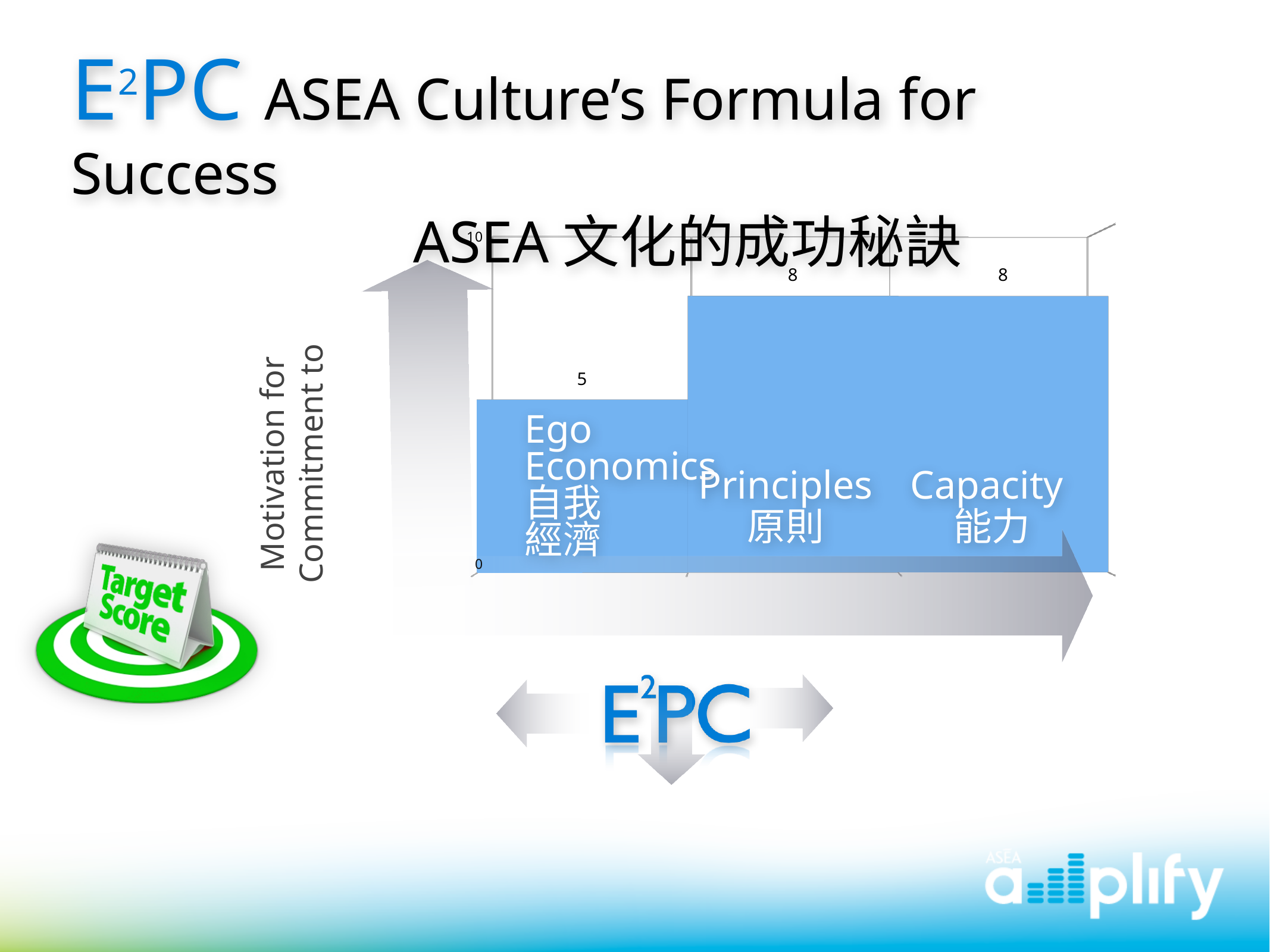
Which category has the lowest value? Ego Economics Which is larger, the value for Capacity or the value for Ego Economics? Capacity What is the highest value shown on the vertical axis? 10 What is the label on the vertical axis of the chart? Motivation for Commitment to What is the value for Ego Economics? 5 What is the value for Capacity? 8 What is the value for Principles? 8 What kind of chart is shown on the slide? bar chart Is the value for Principles greater or less than 10? less How many categories are shown in the chart? 3 What is the difference between the values for Principles and Ego Economics? 3